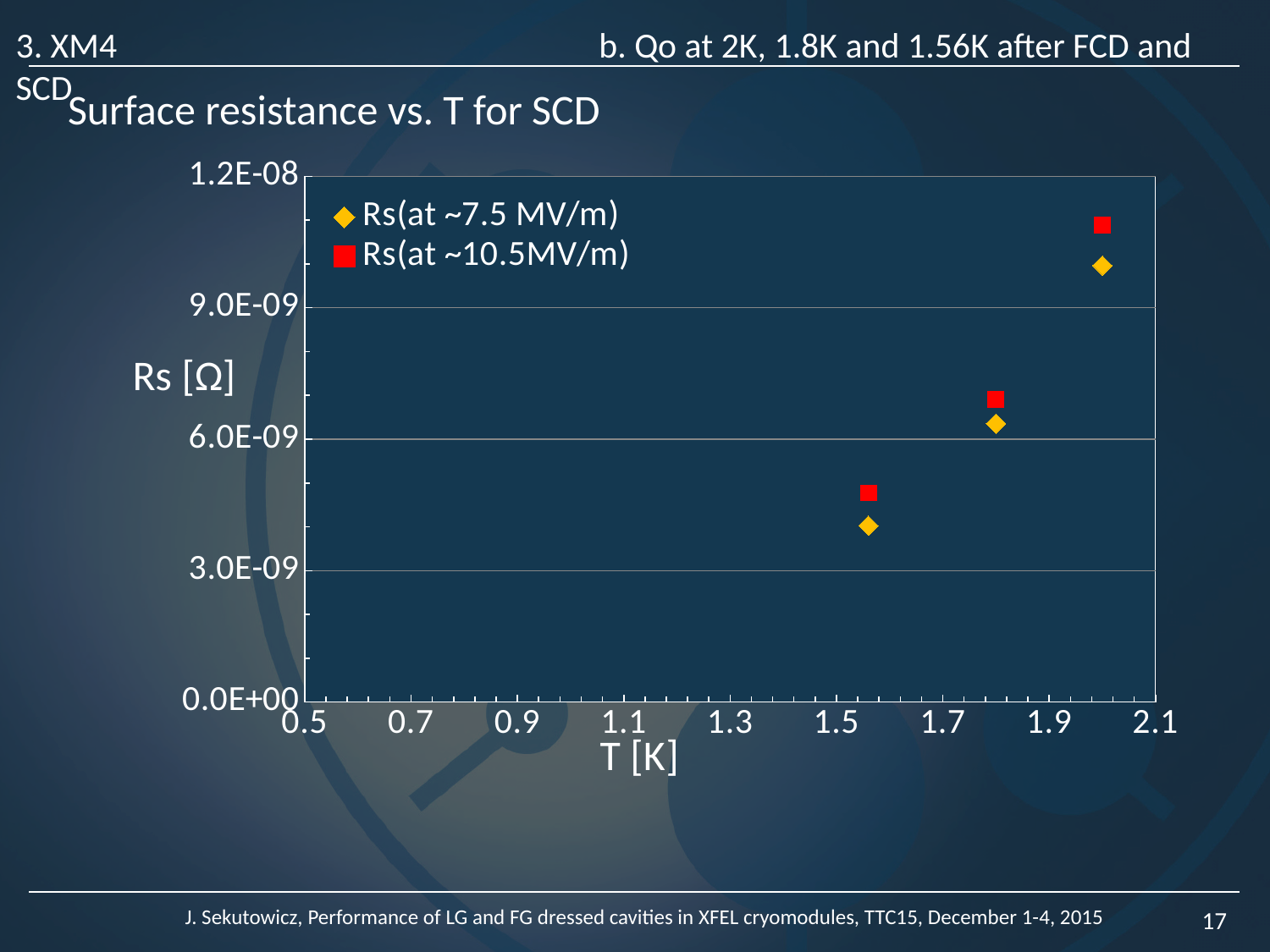
Is the Rs(at ~10.5MV/m) value at about 1.8 K greater or less than 6.0E-09? greater How many series does the chart legend list? 2 At about 2.0 K, which series has the higher Rs value, Rs(at ~7.5 MV/m) or Rs(at ~10.5MV/m)? Rs(at ~10.5MV/m) What kind of chart is shown on the slide? scatter chart Is the Rs(at ~7.5 MV/m) value at the lowest temperature (about 1.56 K) greater or less than 3.0E-09? greater Do the Rs values rise or fall as T increases along the x axis? rise What is the title of the chart? Surface resistance vs. T for SCD How many data points are plotted for the Rs(at ~7.5 MV/m) series? 3 Which series contains the highest plotted Rs value on the chart? Rs(at ~10.5MV/m) What are the two series named in the legend? Rs(at ~7.5 MV/m) and Rs(at ~10.5MV/m) Is the Rs(at ~7.5 MV/m) value at the lowest temperature (about 1.56 K) greater or less than 6.0E-09? less